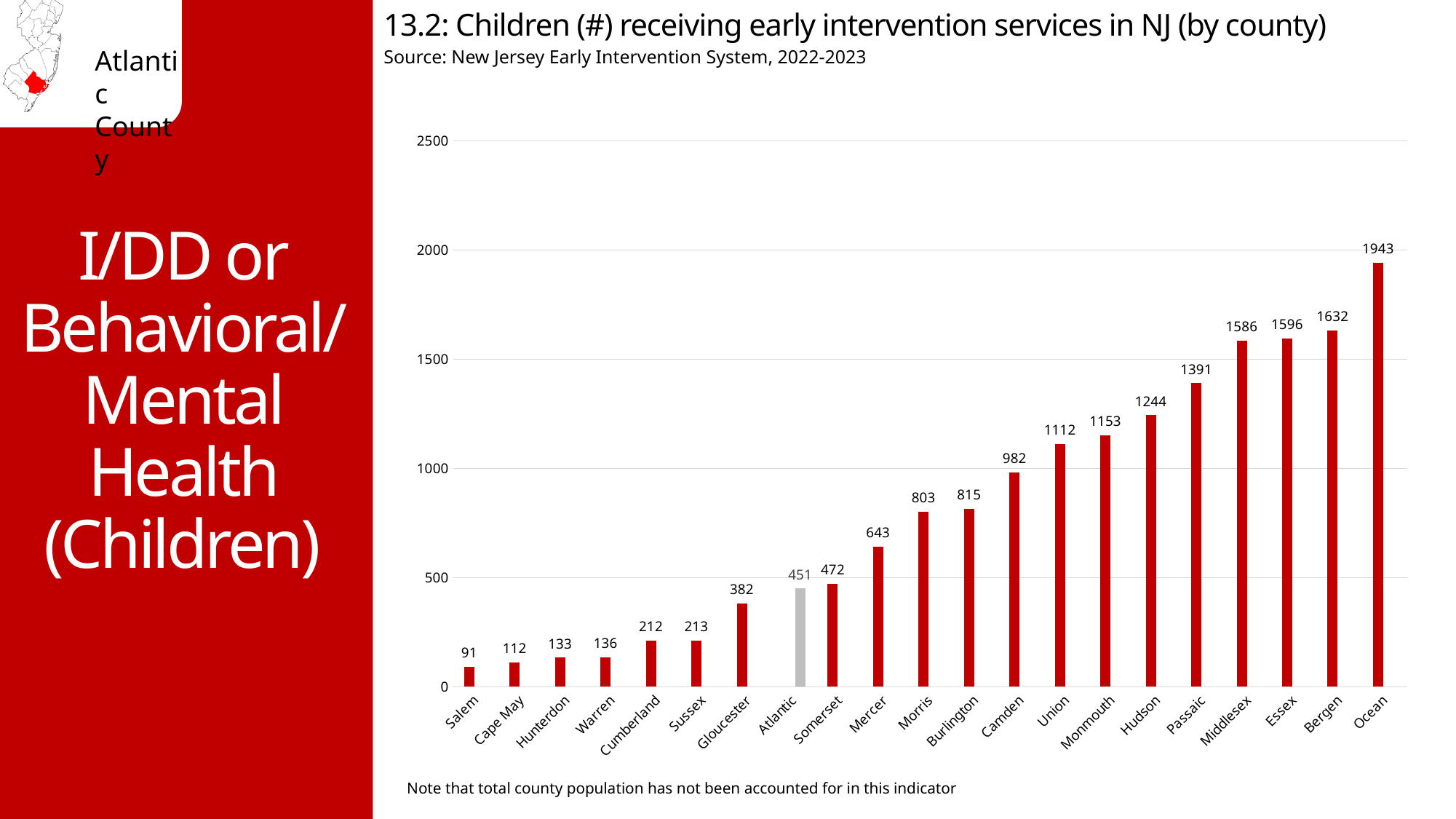
What is the difference between the values for Bergen and Essex? 36 Which county has a larger value, Mercer or Morris? Morris Do the values rise or fall moving from left to right along the x axis? Rise Is the value for Hudson greater or less than 1000? greater What kind of chart is shown on the slide? Bar chart What is the value shown for Camden County? 982 How many counties are shown on the x axis of the chart? 21 What is the difference between the values for Ocean and Salem? 1852 Which county has the lowest number of children receiving early intervention services? Salem How many children received early intervention services in Atlantic County? 451 Which county has the highest number of children receiving early intervention services? Ocean What is the value shown for Ocean County? 1943